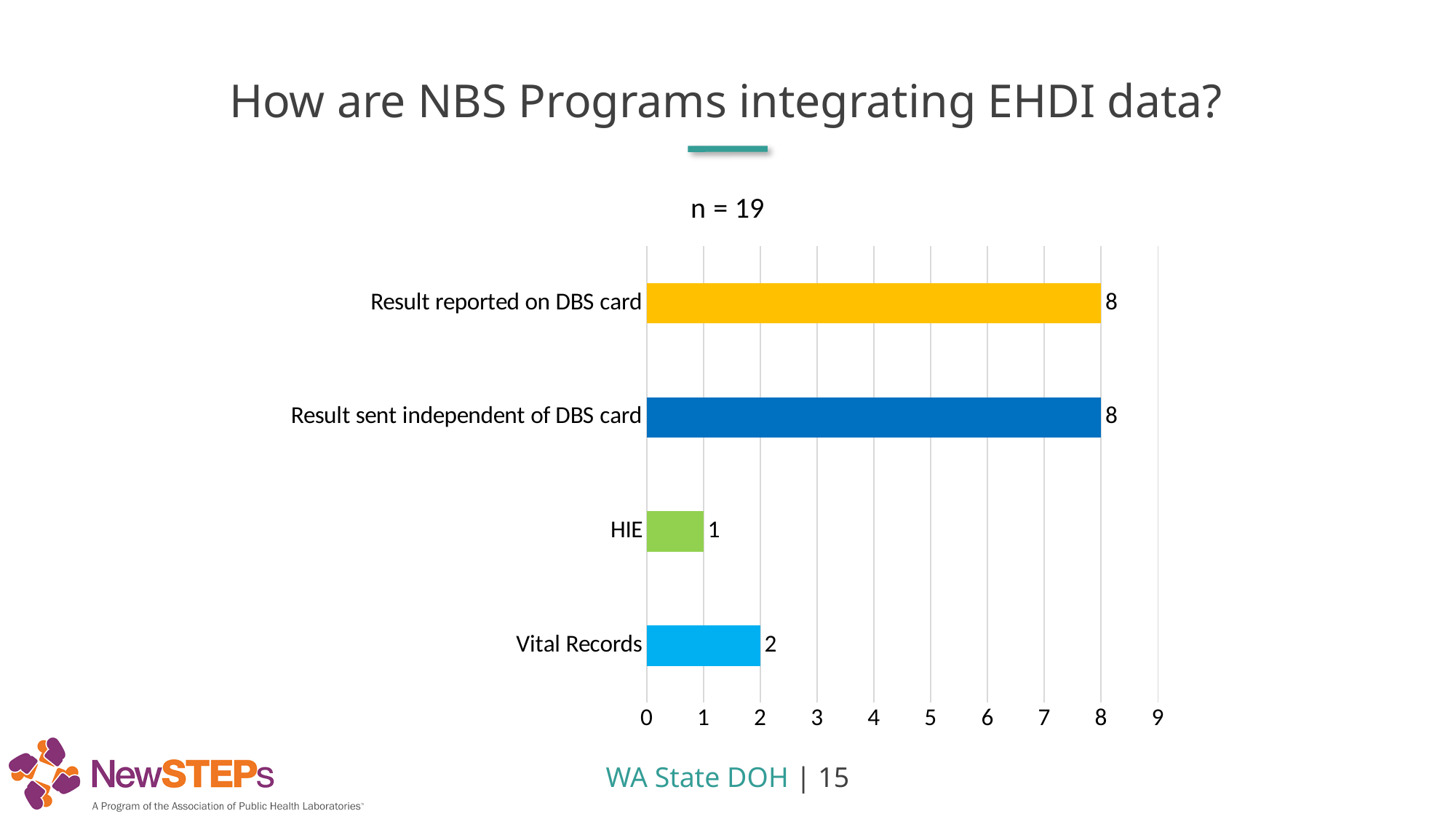
Which category has the lowest value? HIE What is the value for Vital Records? 2 What is the difference between the values for Vital Records and HIE? 1 What is the value for HIE? 1 What kind of chart is shown on the slide? Bar chart How many categories are shown in the chart? 4 What is the value for Result sent independent of DBS card? 8 Which is larger, the value for Vital Records or the value for HIE? Vital Records What is the value for Result reported on DBS card? 8 What is the chart's title? n = 19 Is the value for Result sent independent of DBS card greater or less than 5? greater What is the difference between the values for Result reported on DBS card and Vital Records? 6